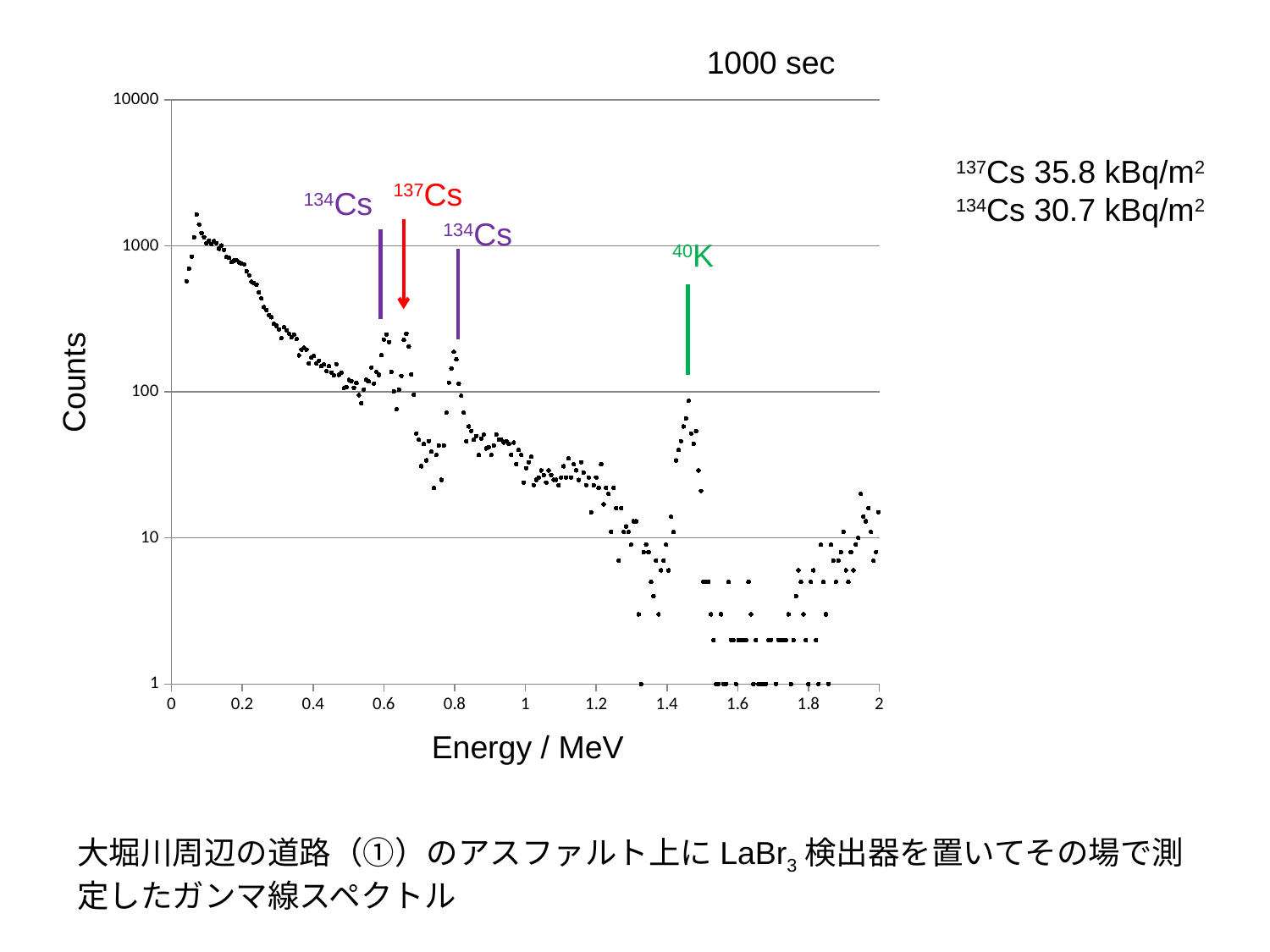
Is the highest count in the spectrum at the low-energy end or the high-energy end of the x axis? low-energy end Which peak has the larger count, the 137Cs peak near 0.66 MeV or the 40K peak near 1.46 MeV? 137Cs peak What is the lowest count value plotted on the chart? 1 What is the label of the x axis? Energy / MeV How many isotope peaks are annotated with labels on the chart? 4 What measurement time is shown above the chart? 1000 sec Is the peak count near 0.1 MeV greater or less than 1000? greater Are the counts around 1.7 MeV greater or less than 10? less Is the count at the 137Cs peak (around 0.66 MeV) greater or less than 100? greater Do the counts generally rise or fall as energy increases from 0 to 2 MeV? fall What kind of chart is shown on the slide? scatter plot